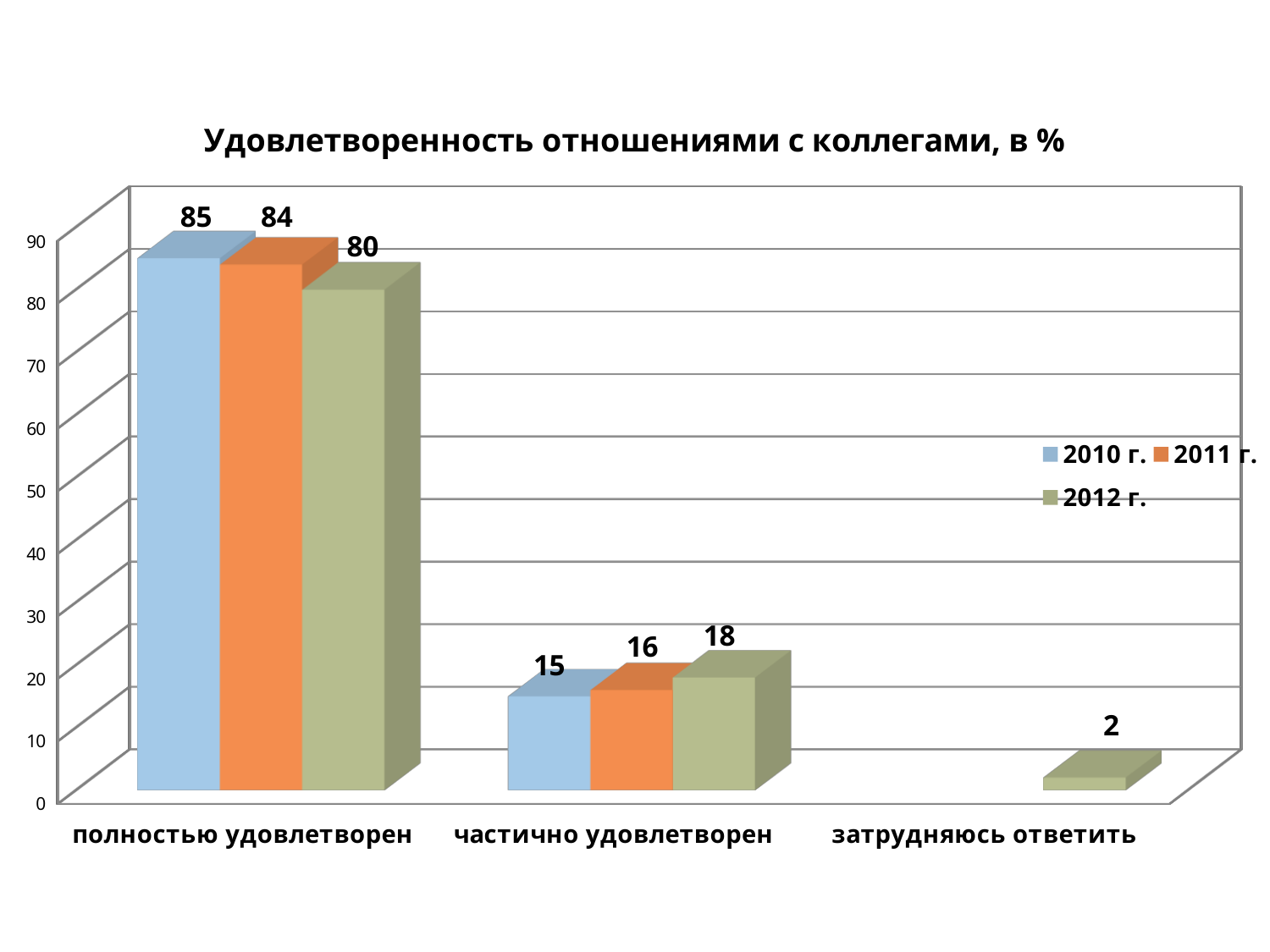
What is the value for 2010 г. in the 'полностью удовлетворен' category? 85 How many categories are shown on the x axis? 3 Which year has the highest value in the 'полностью удовлетворен' category? 2010 г. Does the 2012 г. series rise or fall from 'полностью удовлетворен' to 'затрудняюсь ответить'? fall What kind of chart is shown on the slide? bar chart What is the difference between the 2010 г. and 2012 г. values in the 'полностью удовлетворен' category? 5 What is the title of the chart? Удовлетворенность отношениями с коллегами, в % Which is larger: the 2011 г. value for 'частично удовлетворен' or the 2012 г. value for 'частично удовлетворен'? 2012 г. Which year has the lowest value in the 'частично удовлетворен' category? 2010 г. What is the value for 2012 г. in the 'затрудняюсь ответить' category? 2 What is the value for 2012 г. in the 'частично удовлетворен' category? 18 How many series does the legend list? 3